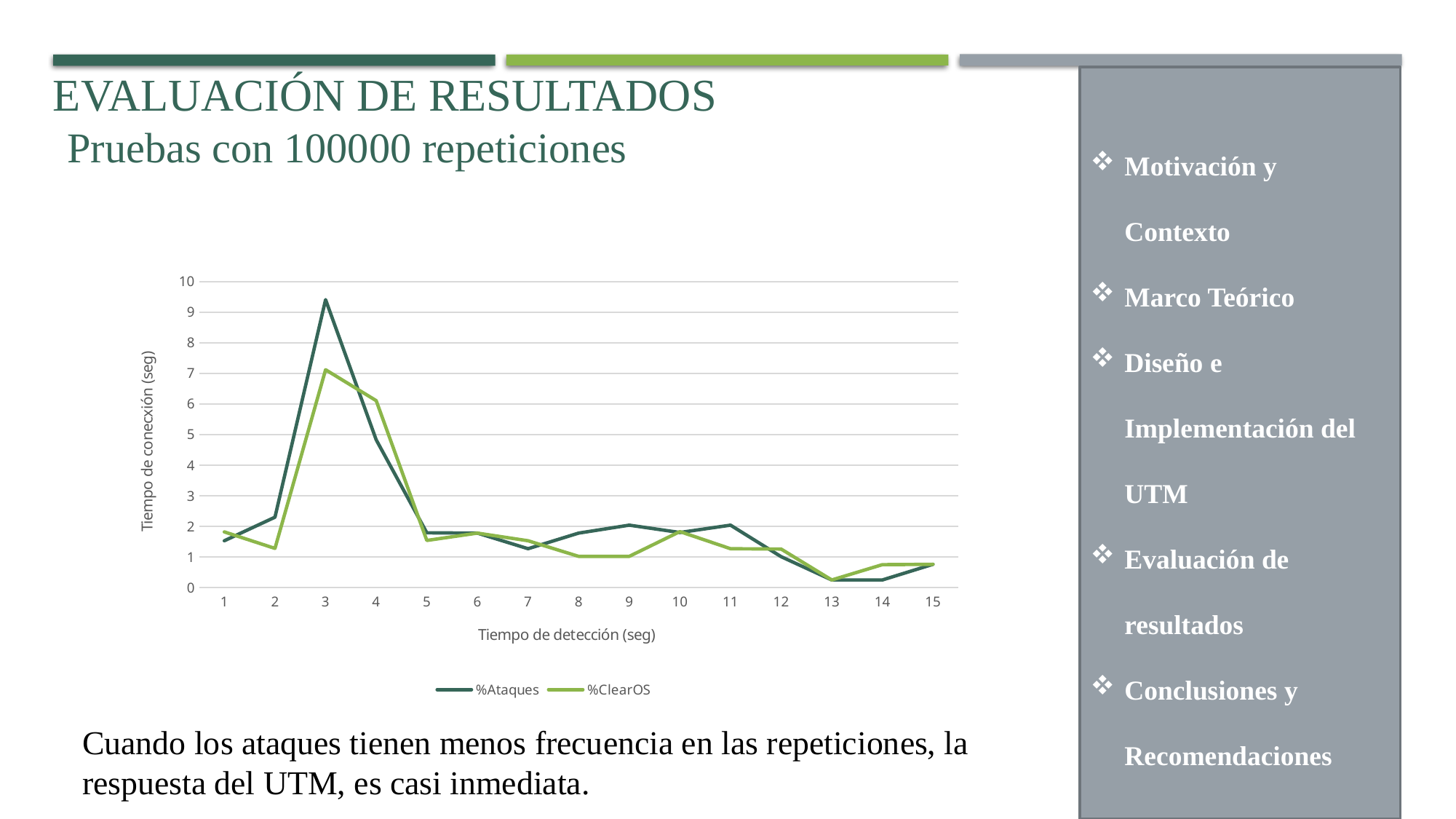
Is the value of %Ataques at detection time 3 greater or less than 8? greater Between detection times 3 and 5, does the %Ataques line rise or fall? fall At detection time 4, which series has the higher value, %Ataques or %ClearOS? %ClearOS Is the value of %ClearOS at detection time 3 greater or less than 8? less What kind of chart is shown on the slide? line chart Is the value of %ClearOS at detection time 13 greater or less than 1? less How many points along the x axis (Tiempo de detección) does each line have? 15 What is the title of the chart's x axis? Tiempo de detección (seg) How many series does the chart legend list? 2 At which detection time does the %Ataques line reach its highest value? 3 At which detection time does the %ClearOS line reach its highest value? 3 At detection time 3, which series has the higher value, %Ataques or %ClearOS? %Ataques